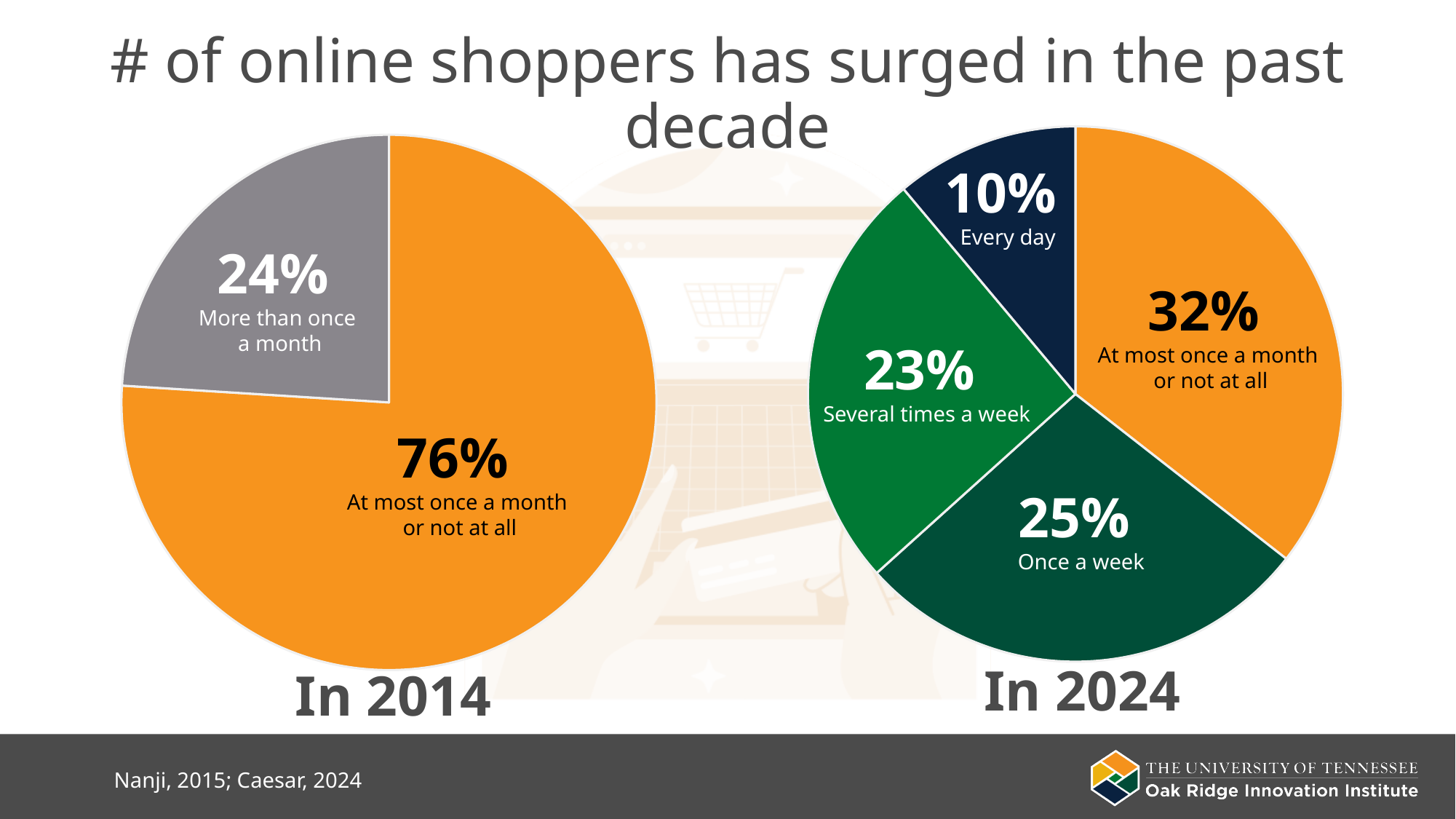
In the 'In 2014' pie chart, what share of shoppers shop more than once a month? 24% In the 'In 2024' pie chart, which is larger: the 'Once a week' slice or the 'Several times a week' slice? Once a week In the 'In 2024' pie chart, which category has the largest slice? At most once a month or not at all In the 'In 2024' pie chart, which category has the smallest slice? Every day In the 'In 2024' pie chart, what share of shoppers shop every day? 10% What is the difference between the 'At most once a month or not at all' share in the 'In 2014' chart and in the 'In 2024' chart? 44 percentage points In the 'In 2024' pie chart, how many slices are there? 4 In the 'In 2024' pie chart, what share of shoppers shop once a week? 25% What type of chart is used on the slide? Pie chart In the 'In 2014' pie chart, what share of shoppers shop at most once a month or not at all? 76% In the 'In 2014' pie chart, how many slices are there? 2 In the 'In 2024' pie chart, what share of shoppers shop several times a week? 23%